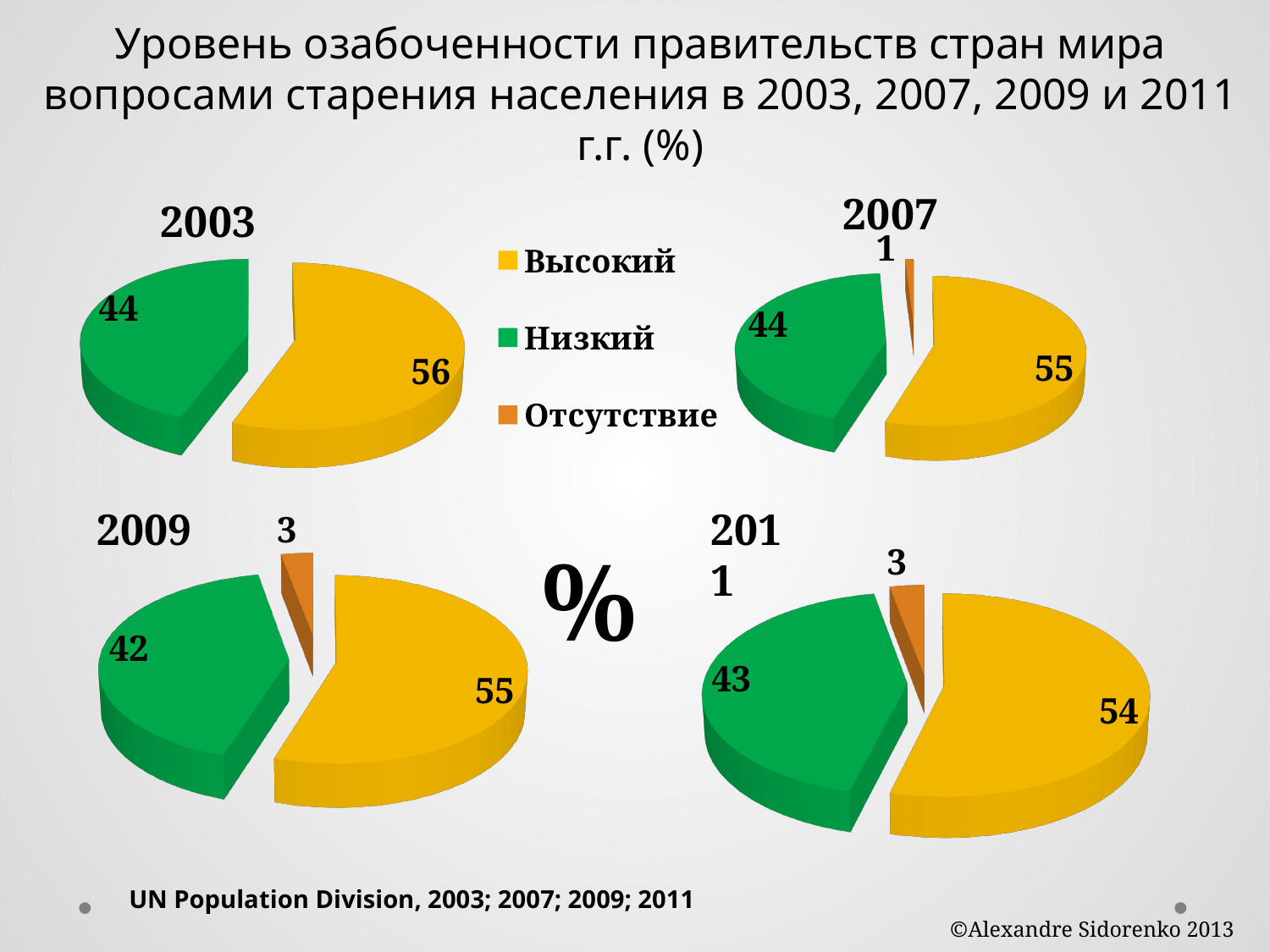
In the 2009 pie chart, what is the value for Низкий? 42 How many pie charts are shown on the slide? 4 In the 2011 pie chart, which category has the largest slice? Высокий In the 2011 pie chart, what is the value for Высокий? 54 What kind of chart is used for the 2003 data? Pie chart In the 2009 pie chart, which category has the smallest slice? Отсутствие In the 2003 pie chart, what is the value for Низкий? 44 In the 2011 pie chart, which is larger, Низкий or Отсутствие? Низкий In the 2007 pie chart, what is the value for Отсутствие? 1 How many categories does the legend list? 3 In the 2007 pie chart, what is the difference between the values for Высокий and Низкий? 11 In the 2003 pie chart, what is the value for Высокий? 56